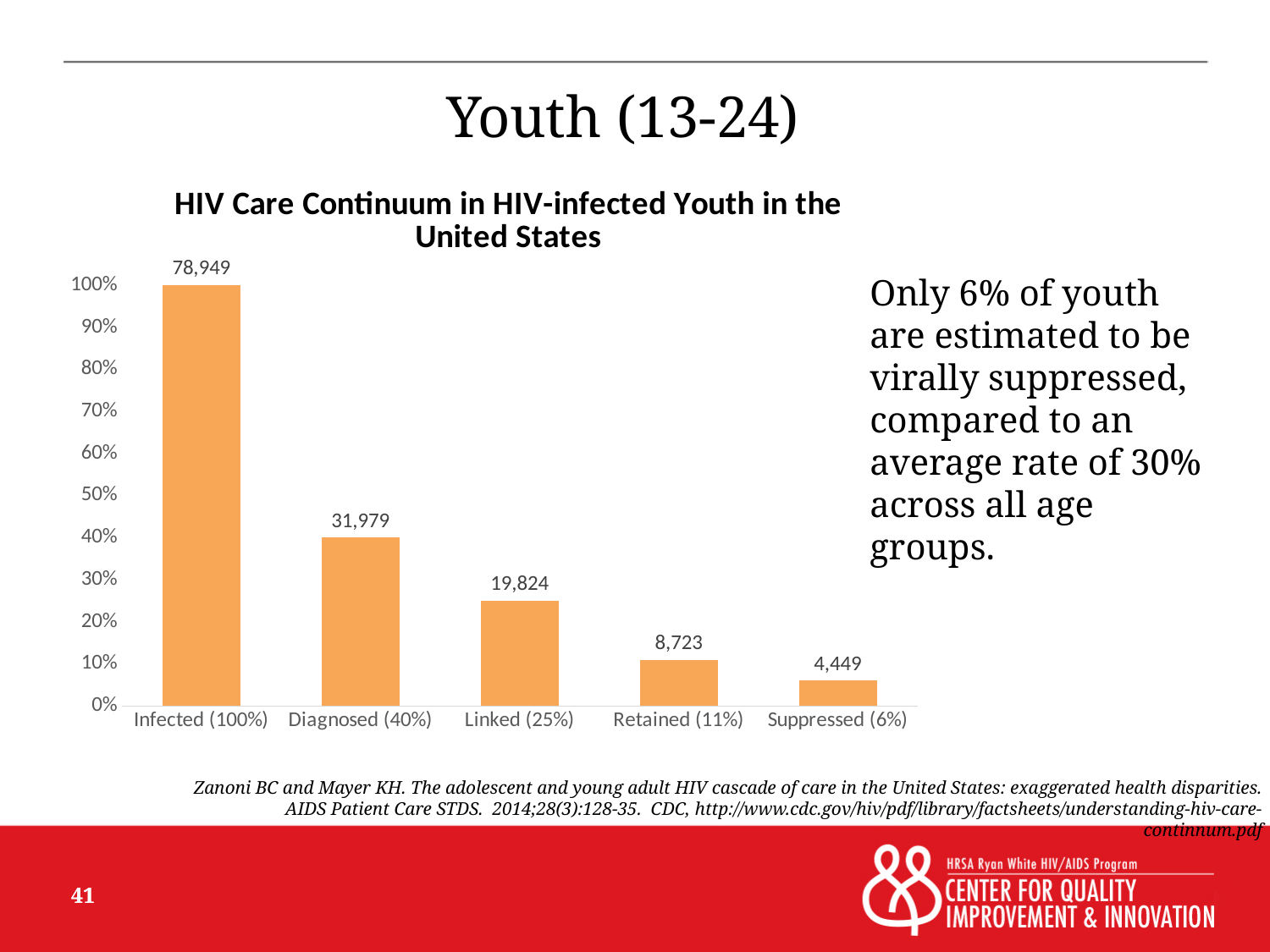
Which is larger, the value for Retained (11%) or the value for Suppressed (6%)? Retained (11%) What is the data label on the Diagnosed (40%) bar? 31,979 What is the data label on the Retained (11%) bar? 8,723 What is the data label on the Suppressed (6%) bar? 4,449 Which category has the lowest bar? Suppressed (6%) What type of chart is shown? bar chart What is the data label on the Linked (25%) bar? 19,824 Which category has the highest bar? Infected (100%) Is the bar for Linked (25%) greater or less than 30% on the axis? less What is the data label on the Infected (100%) bar? 78,949 How many categories are shown on the x axis? 5 What is the difference between the data labels for Diagnosed (40%) and Linked (25%)? 12,155